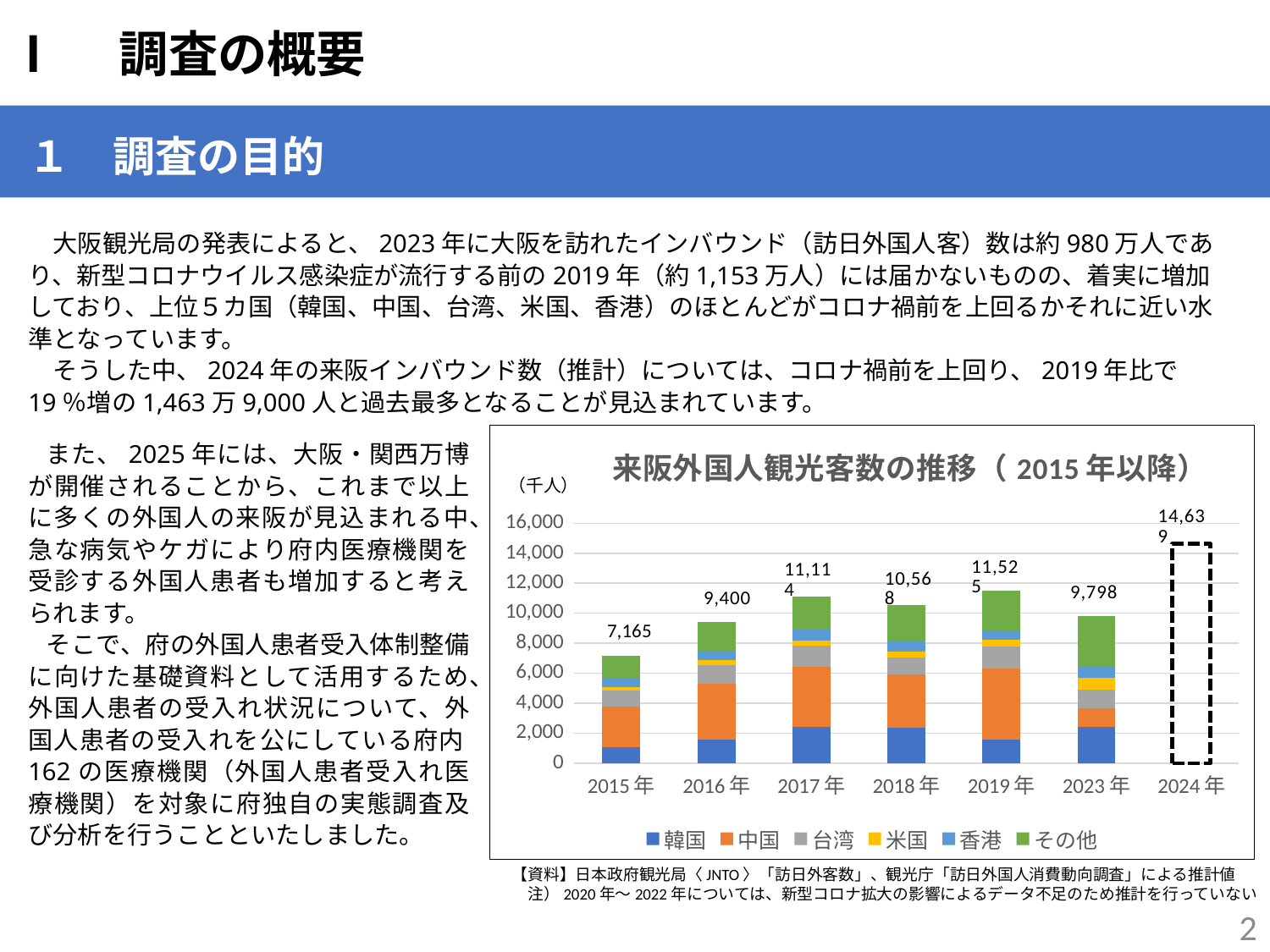
What is the total value labelled for 2024年? 14,639 Which year has the lowest total value in the chart? 2015年 How many year categories are shown on the x axis of the chart? 7 What is the title of the chart? 来阪外国人観光客数の推移（2015年以降） What is the total value labelled for 2019年? 11,525 How many series does the chart's legend list? 6 What type of chart is shown on the slide? Stacked bar chart Which is larger, the total for 2017年 or the total for 2018年? 2017年 Which year has the highest total value in the chart? 2024年 Is the total value for 2023年 greater or less than 10,000? less What is the difference between the total for 2024年 and the total for 2019年? 3,114 What is the total value labelled for 2015年? 7,165